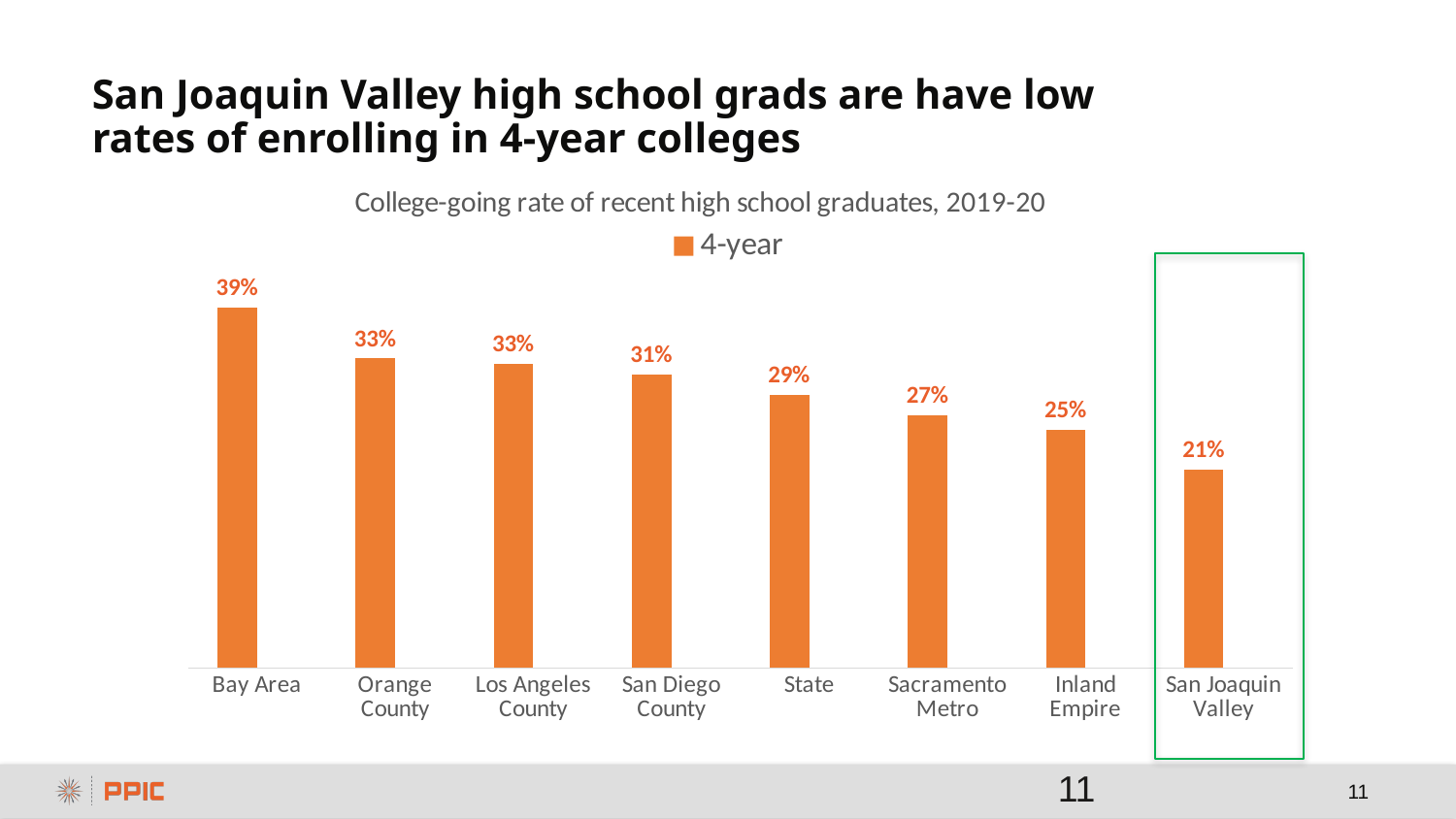
What is the difference between the Bay Area and San Joaquin Valley 4-year college-going rates? 18 percentage points What is the title of the chart? College-going rate of recent high school graduates, 2019-20 How many series does the legend list? 1 Which region has the lowest 4-year college-going rate? San Joaquin Valley What is the 4-year college-going rate for the Bay Area? 39% What is the 4-year college-going rate for San Joaquin Valley? 21% Which has a higher 4-year college-going rate, San Diego County or Inland Empire? San Diego County Which region has the highest 4-year college-going rate? Bay Area What is the 4-year college-going rate for Sacramento Metro? 27% What kind of chart is shown on the slide? Bar chart How many regions are shown on the chart? 8 What is the 4-year college-going rate for the State? 29%